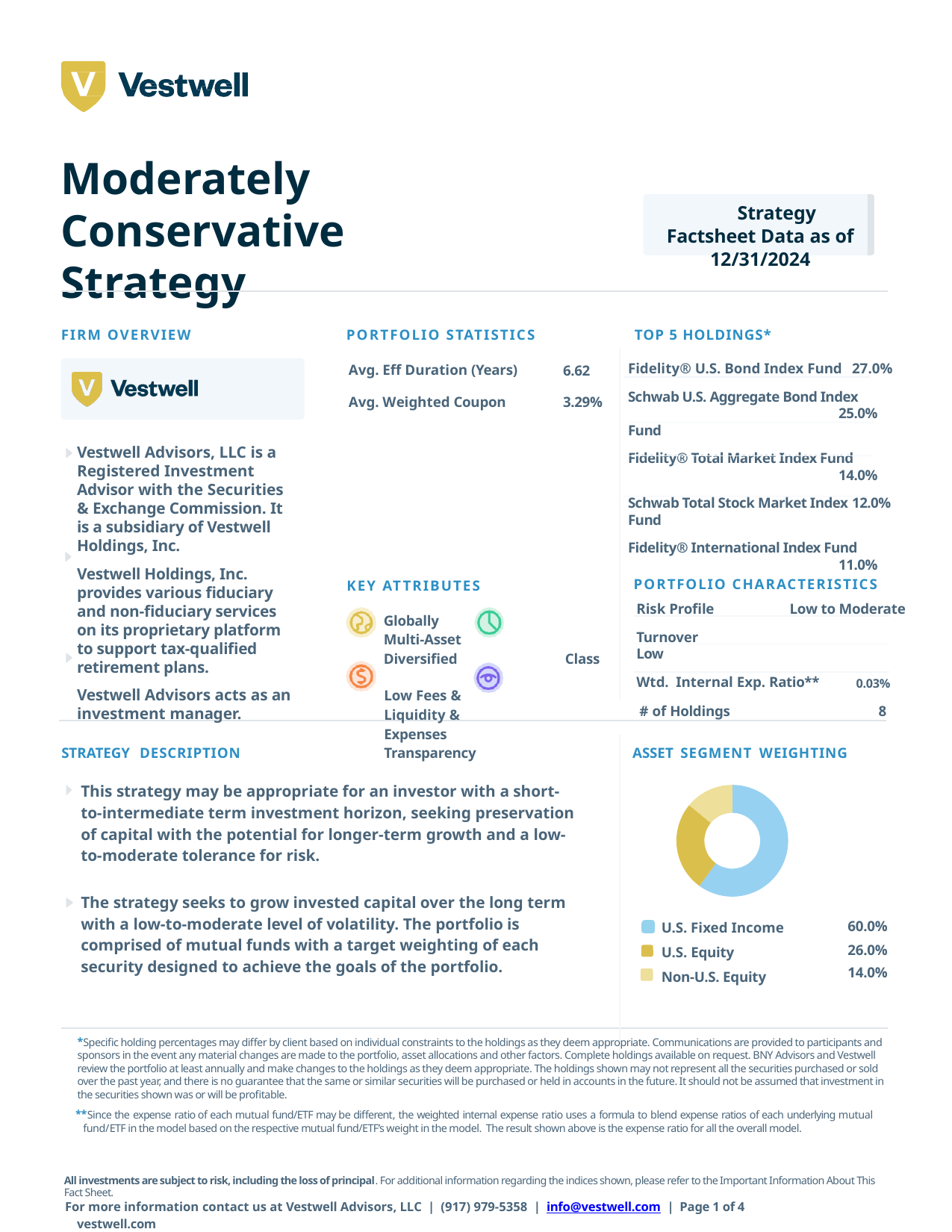
What colour represents U.S. Fixed Income in the Asset Segment Weighting chart? Light blue What type of chart is shown under Asset Segment Weighting? Pie chart (donut) In the Asset Segment Weighting chart, what is the difference between the U.S. Equity and Non-U.S. Equity weightings? 12.0% In the Asset Segment Weighting chart, what is the difference between the U.S. Fixed Income and U.S. Equity weightings? 34.0% In the Asset Segment Weighting chart, what is the combined weighting of U.S. Equity and Non-U.S. Equity? 40.0% In the Asset Segment Weighting chart, what is the weighting for Non-U.S. Equity? 14.0% Which asset segment has the smallest weighting in the Asset Segment Weighting chart? Non-U.S. Equity In the Asset Segment Weighting chart, which is larger: U.S. Equity or Non-U.S. Equity? U.S. Equity In the Asset Segment Weighting chart, what is the weighting for U.S. Equity? 26.0% How many asset segments are shown in the Asset Segment Weighting chart? 3 Which asset segment has the largest weighting in the Asset Segment Weighting chart? U.S. Fixed Income In the Asset Segment Weighting chart, what is the weighting for U.S. Fixed Income? 60.0%